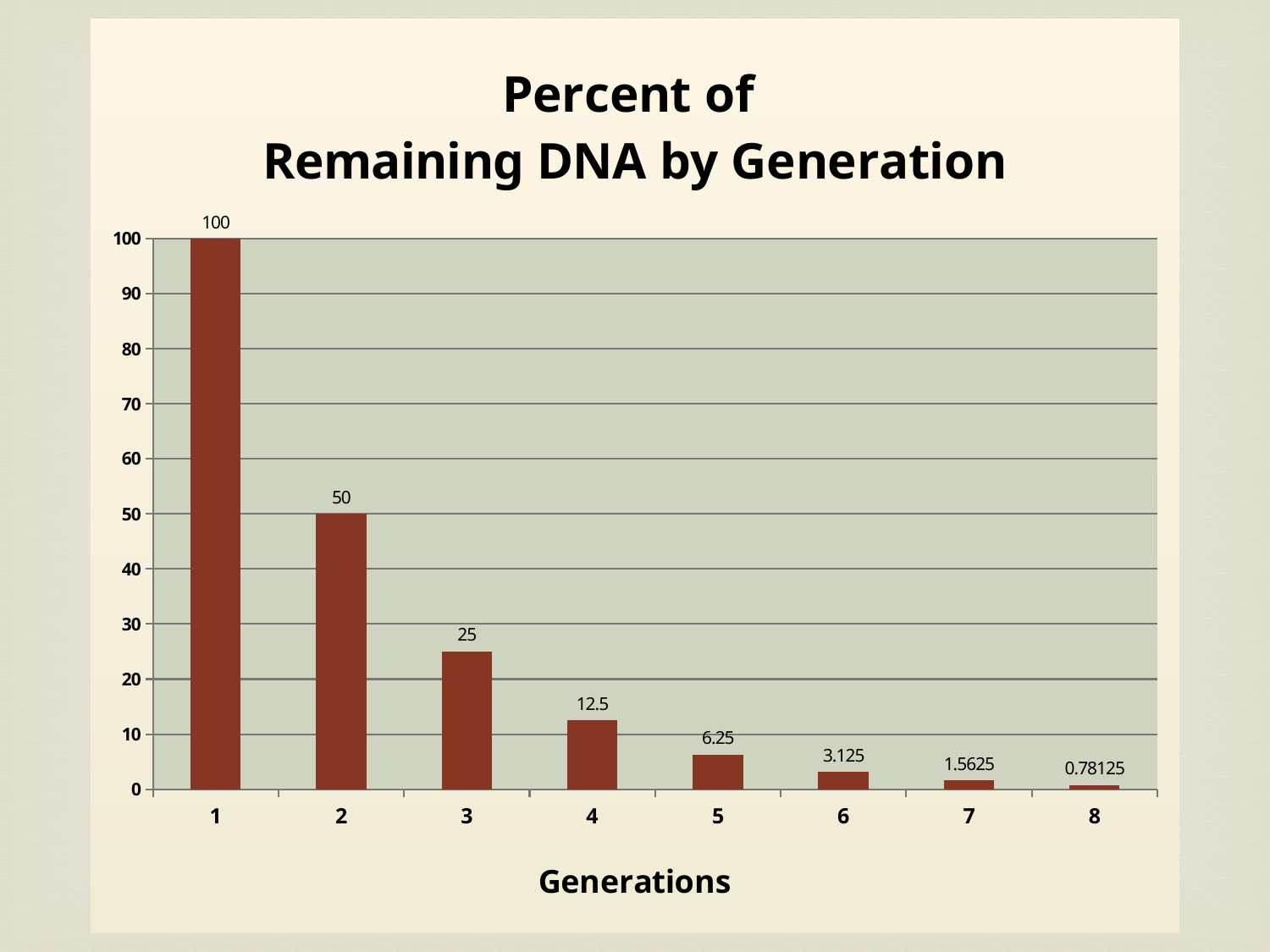
Which generation has the highest value? 1 What is the value for generation 7? 1.5625 Is the value for generation 3 greater or less than 20? greater Which is larger, the value for generation 5 or generation 6? generation 5 What is the value for generation 8? 0.78125 What kind of chart is shown? bar chart What is the value for generation 1? 100 Which generation has the lowest value? 8 What is the value for generation 4? 12.5 Do the values rise or fall as the generation number increases? fall What is the difference between the values for generation 2 and generation 3? 25 How many generations are shown on the x axis? 8